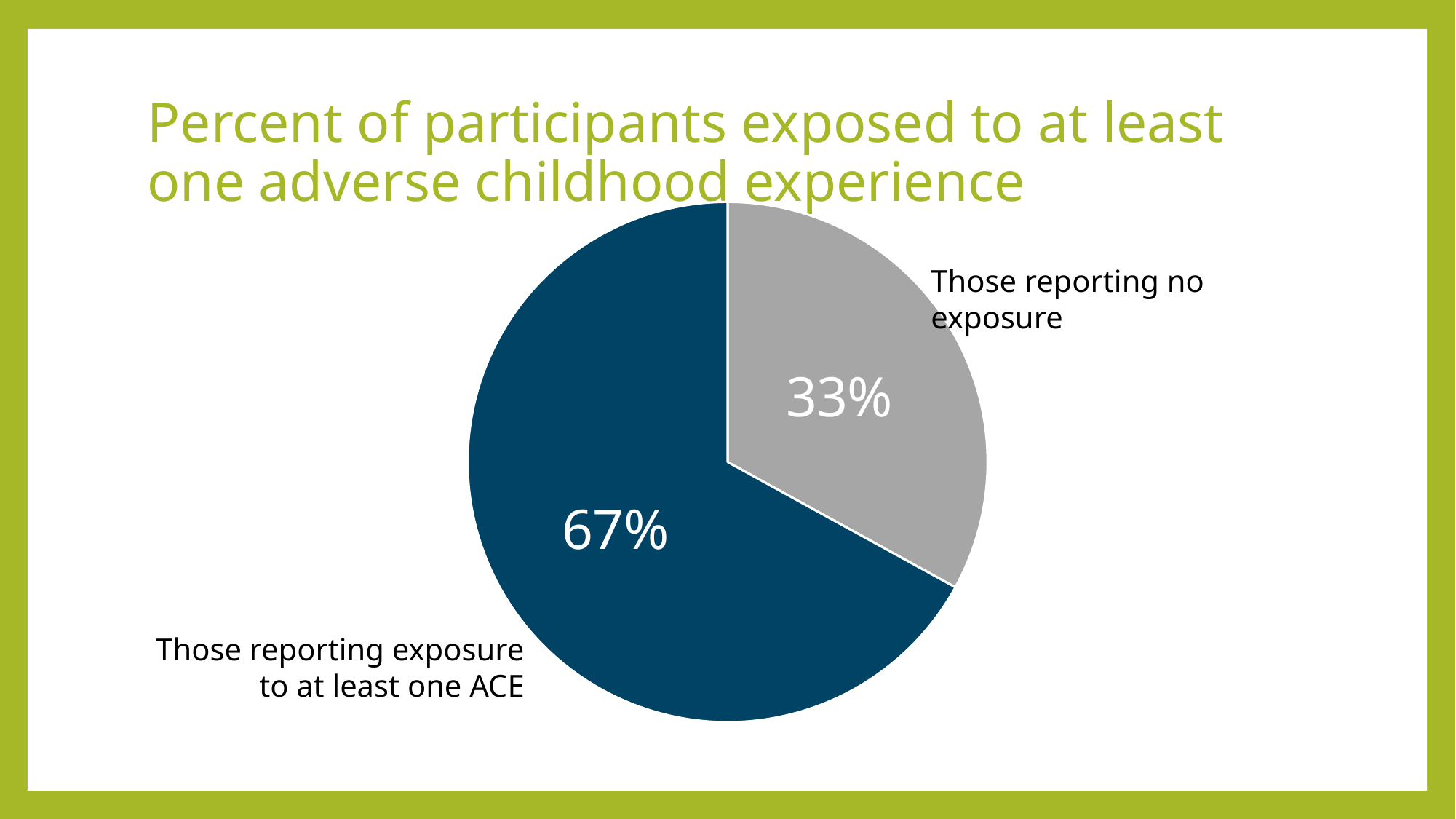
What is the difference in percentage points between those reporting exposure to at least one ACE and those reporting no exposure? 34 What share of the pie is taken by those reporting no exposure? 33% What percentage of participants reported exposure to at least one ACE? 67% What colour is the slice for those reporting exposure to at least one ACE? dark blue What percentage of participants reported no exposure? 33% What kind of chart is shown on the slide? pie chart What is the title of the chart? Percent of participants exposed to at least one adverse childhood experience Which slice of the pie is the largest? Those reporting exposure to at least one ACE Which is larger: the share of those reporting no exposure or the share of those reporting exposure to at least one ACE? Those reporting exposure to at least one ACE Which slice of the pie is the smallest? Those reporting no exposure How many slices does the pie chart have? 2